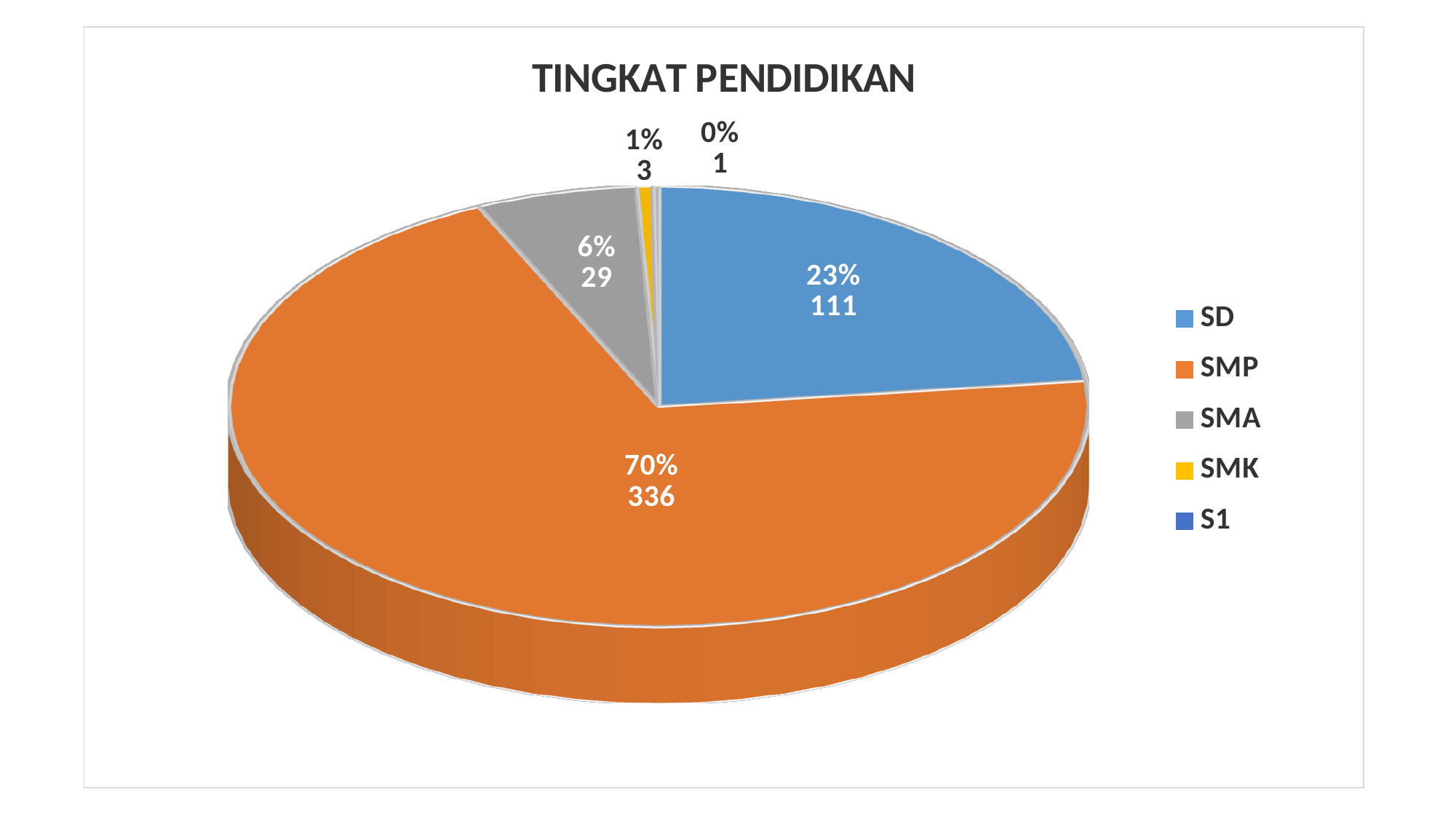
What share of the pie does SMP represent? 70% How many categories does the legend list? 5 Which category has the largest slice? SMP What is the value for SMK? 3 What share of the pie does SD represent? 23% What is the value for SD? 111 What is the value for SMA? 29 What is the difference between the values for SMP and SD? 225 What is the title of the chart? TINGKAT PENDIDIKAN What is the value for SMP? 336 Which category has the smallest slice? S1 What kind of chart is shown on the slide? pie chart